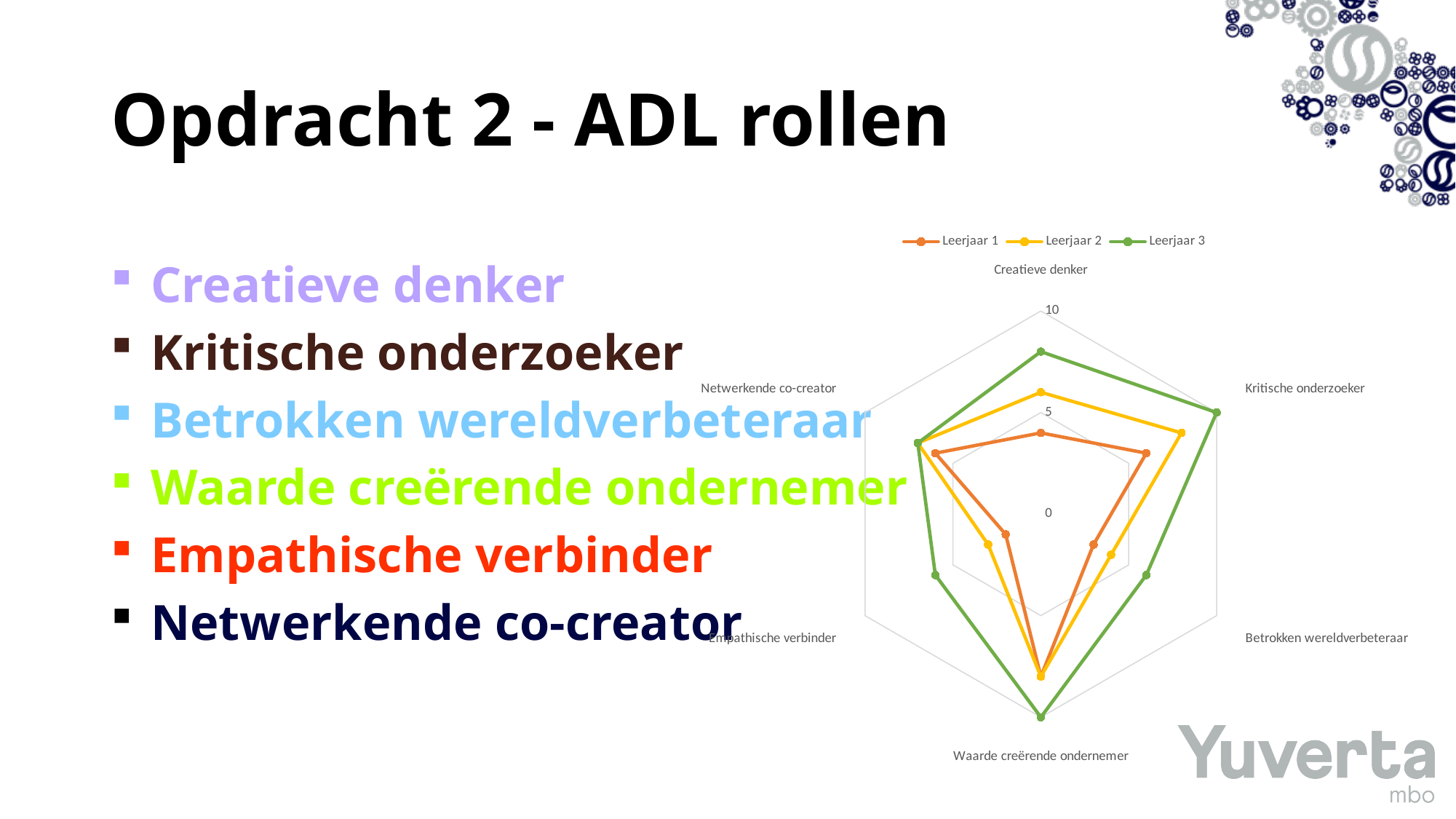
For Leerjaar 1, which category has the highest value? Waarde creërende ondernemer How many series does the chart legend list? 3 For Leerjaar 1, which category has the lowest value? Empathische verbinder Is the value for Kritische onderzoeker in Leerjaar 3 greater or less than 5? greater What kind of chart is shown on the slide? Radar chart Is the value for Creatieve denker in Leerjaar 1 greater or less than 5? less Which series is drawn in green in the chart? Leerjaar 3 Is the value for Creatieve denker in Leerjaar 3 greater or less than 5? greater For Creatieve denker, which is larger: the value for Leerjaar 1 or for Leerjaar 3? Leerjaar 3 How many categories (axes) does the radar chart have? 6